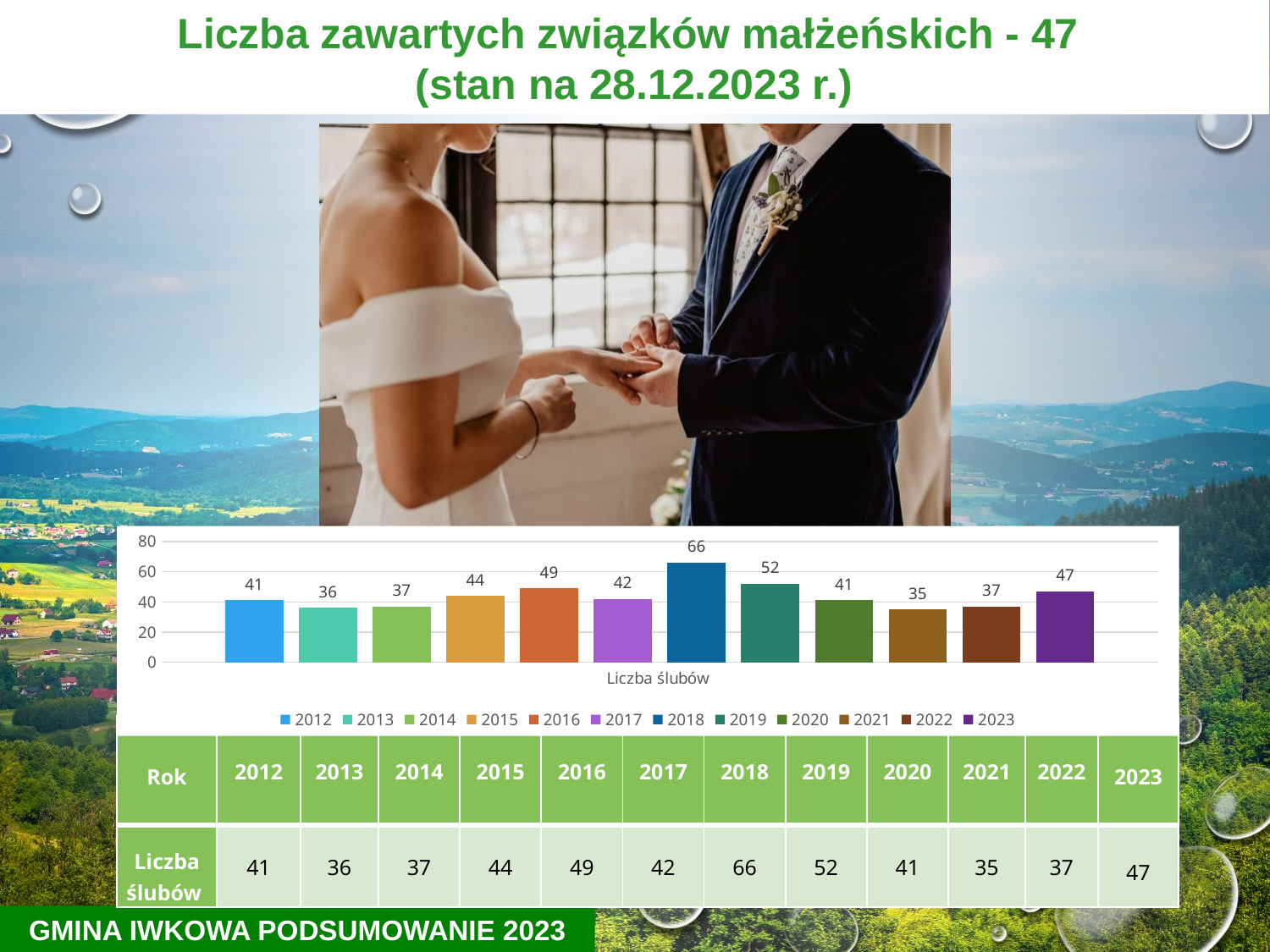
Is the value for 2018 greater or less than 60? greater Which year has the highest number of marriages in the chart? 2018 Which year has the lowest number of marriages in the chart? 2021 What is the value shown for 2023 in the chart? 47 What is the label shown beneath the bars on the x axis? Liczba ślubów What is the difference between the values for 2018 and 2019? 14 What kind of chart is shown on the slide? bar chart How many entries does the chart legend list? 12 How many years are plotted in the chart? 12 What is the number of marriages (Liczba ślubów) shown for 2018? 66 Which year has a larger value, 2015 or 2017? 2015 What is the value shown for 2016 in the chart? 49